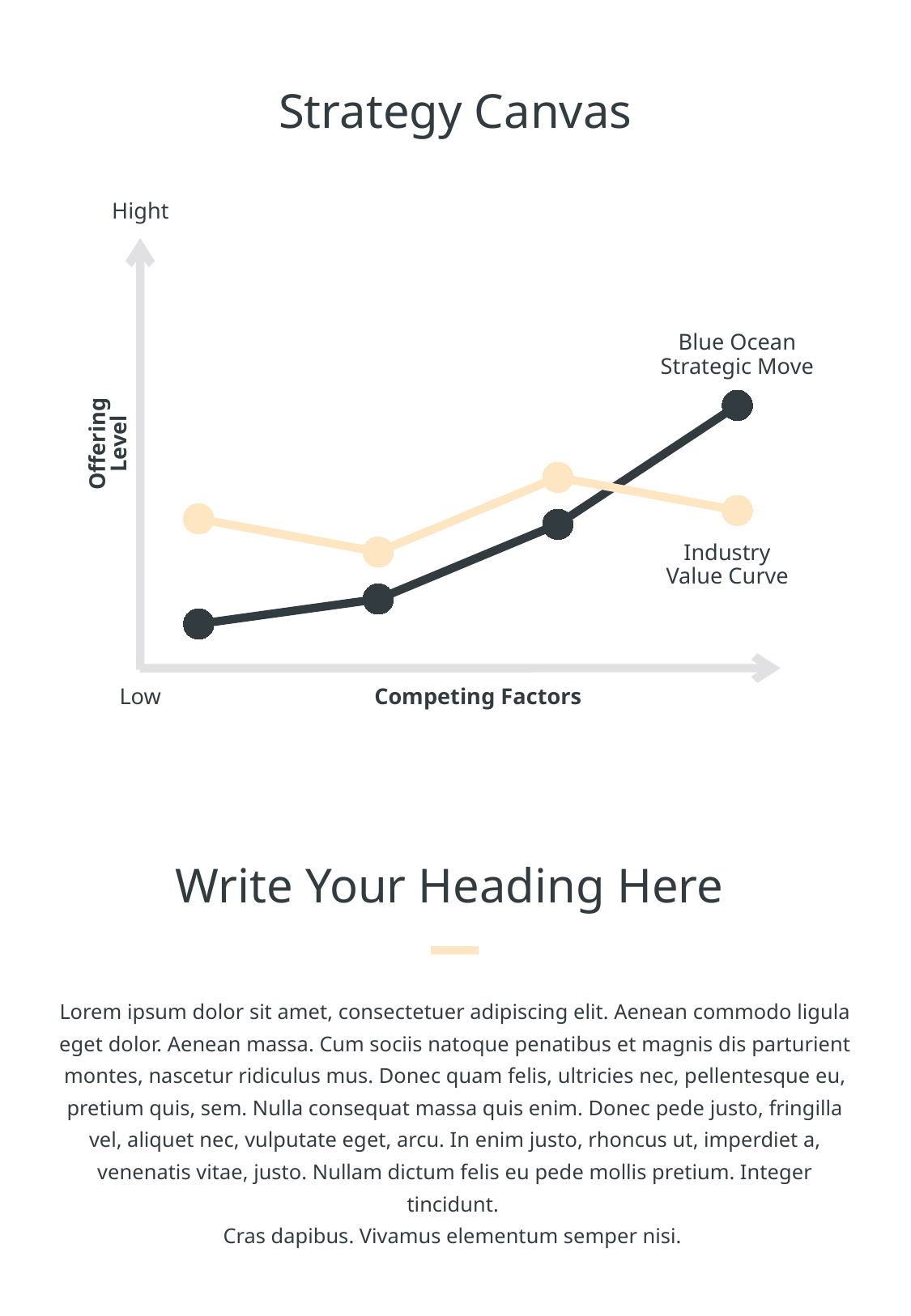
Which point on the Industry Value Curve line has the highest offering level? The third point Which point on the Blue Ocean Strategic Move line has the highest offering level? The rightmost (fourth) point What is the label of the horizontal axis? Competing Factors What kind of chart is shown on the slide? Line chart Which point on the Industry Value Curve line has the lowest offering level? The second point At the rightmost competing factor, which series has the higher offering level: Blue Ocean Strategic Move or Industry Value Curve? Blue Ocean Strategic Move At the leftmost competing factor, which series has the higher offering level: Blue Ocean Strategic Move or Industry Value Curve? Industry Value Curve What is the title of the chart? Strategy Canvas How many data points does the Industry Value Curve line have? 4 Does the Blue Ocean Strategic Move line rise or fall from left to right? Rises How many data points does the Blue Ocean Strategic Move line have? 4 How many series are plotted on the chart? 2